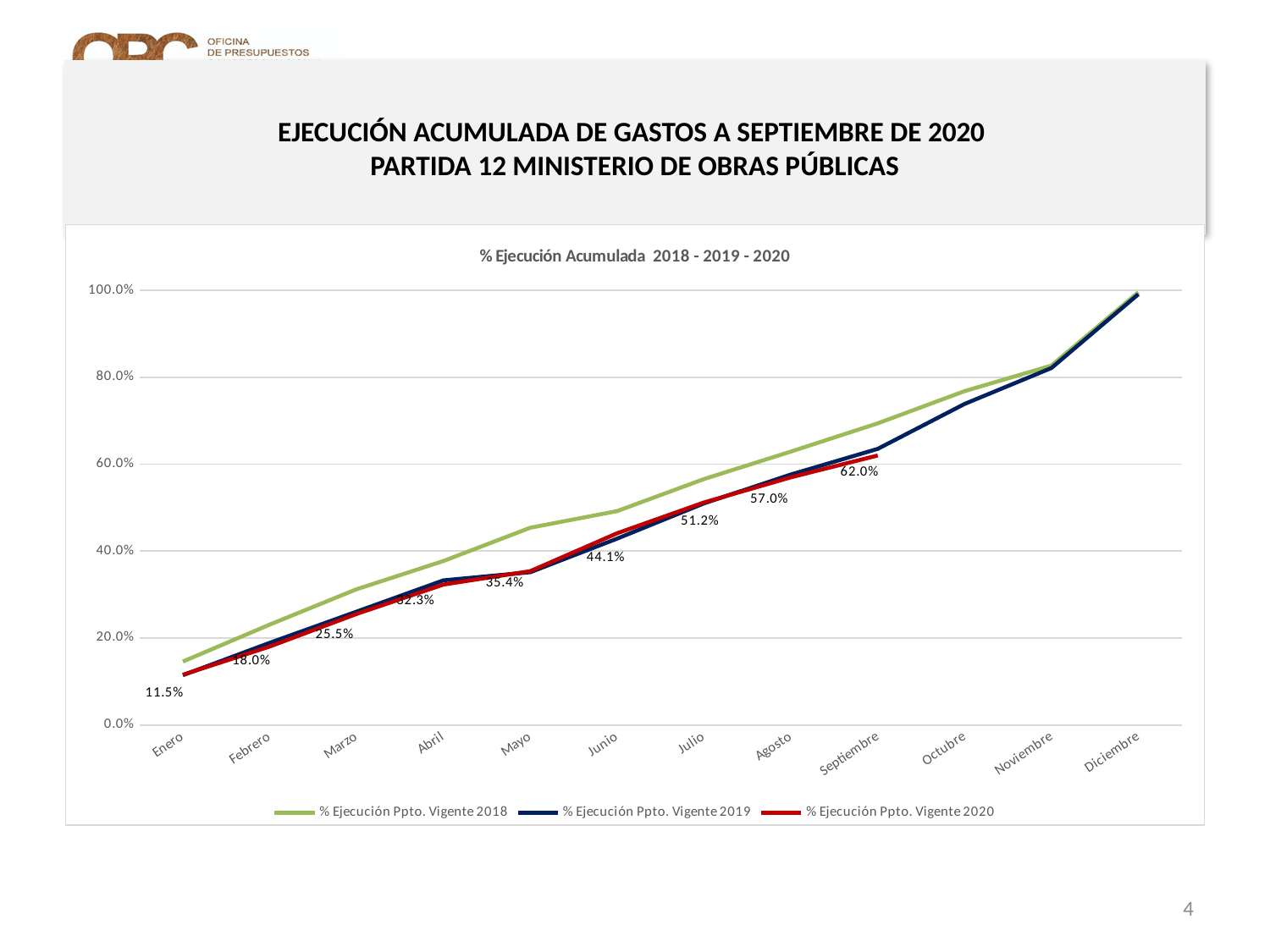
In which month is the % Ejecución Ppto. Vigente 2020 series lowest? Enero What is the value of % Ejecución Ppto. Vigente 2020 for Septiembre? 62.0% What is the difference between the 2020 values for Septiembre and Agosto? 5.0% What is the difference between the 2020 values for Julio and Junio? 7.1% How many series does the legend list? 3 Is the value for % Ejecución Ppto. Vigente 2018 in Mayo greater or less than 40.0%? greater What is the value of % Ejecución Ppto. Vigente 2020 for Junio? 44.1% What kind of chart is shown? Line chart How many months are shown on the x axis? 12 Which series is higher in Junio, % Ejecución Ppto. Vigente 2018 or % Ejecución Ppto. Vigente 2019? % Ejecución Ppto. Vigente 2018 In which month does the % Ejecución Ppto. Vigente 2020 series reach its highest labelled value? Septiembre What is the value of % Ejecución Ppto. Vigente 2020 for Enero? 11.5%